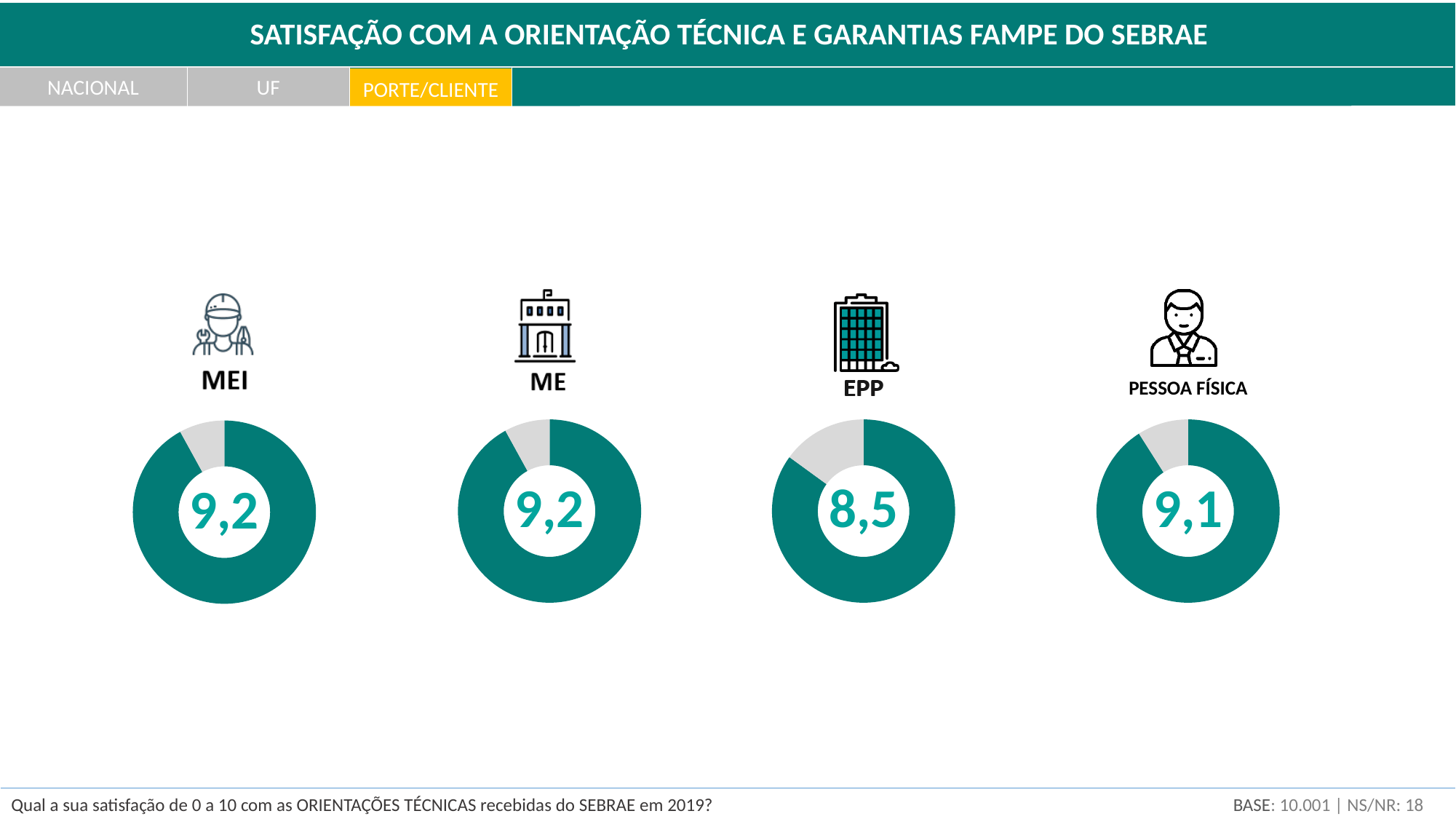
What is the satisfaction score shown in the EPP donut chart? 8,5 What is the satisfaction score shown in the MEI donut chart? 9,2 Which categories share the highest satisfaction score on the slide? MEI and ME How many donut charts are shown on the slide? 4 Which tab is highlighted in yellow below the slide title? PORTE/CLIENTE What is the satisfaction score shown in the PESSOA FÍSICA donut chart? 9,1 What is the satisfaction score shown in the ME donut chart? 9,2 Which has a higher satisfaction score, EPP or PESSOA FÍSICA? PESSOA FÍSICA What is the difference between the MEI score and the EPP score? 0,7 What kind of chart is used to display each satisfaction score? Donut (pie) chart Which category has the lowest satisfaction score on the slide? EPP What is the difference between the PESSOA FÍSICA score and the EPP score? 0,6